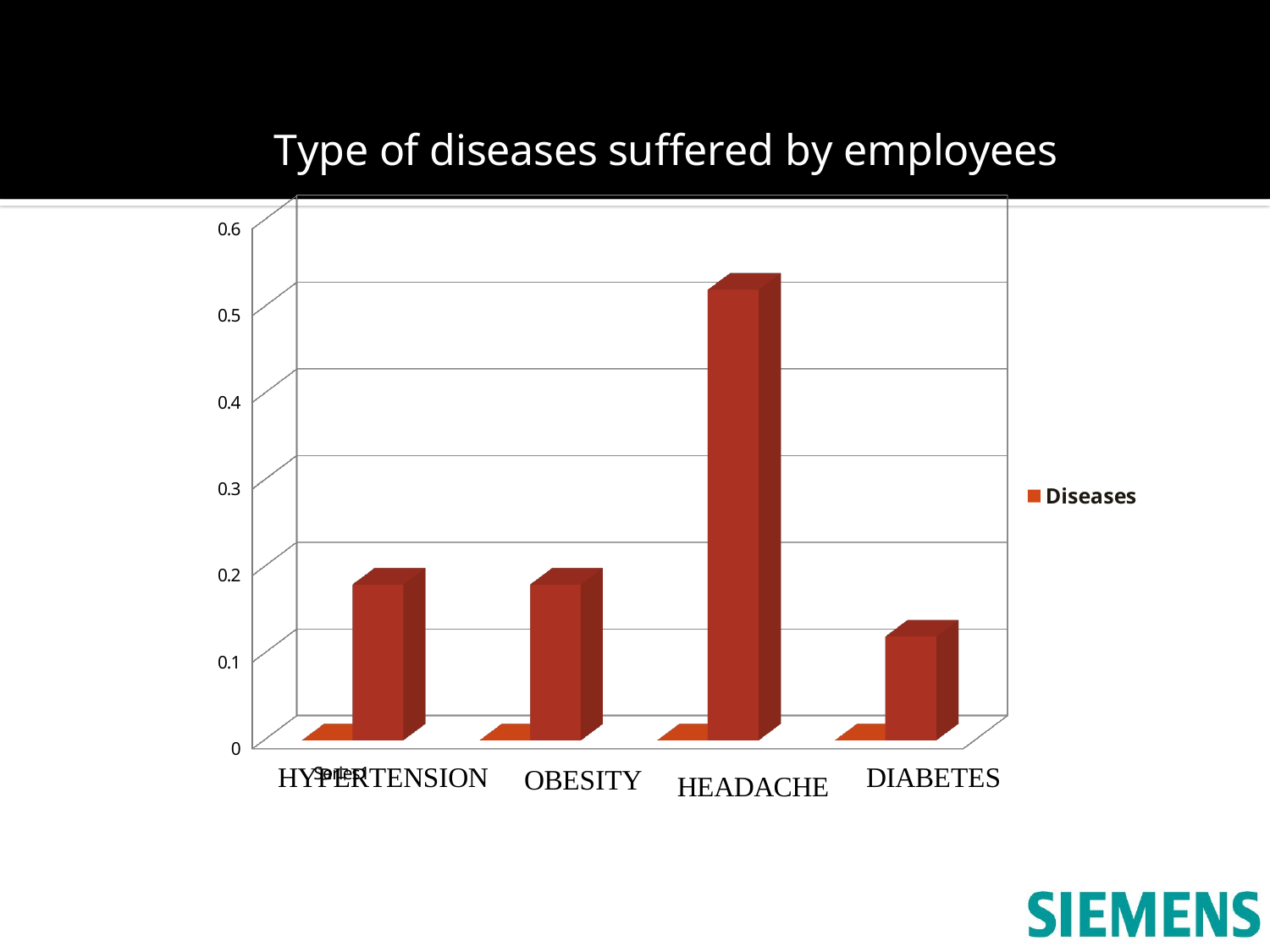
Which has a larger value, OBESITY or DIABETES? OBESITY How many series does the legend list? 1 What is the name of the series shown in the legend? Diseases What kind of chart is shown on the slide? bar chart Is the value for HYPERTENSION greater or less than 0.3? less How many disease categories are shown on the x axis? 4 Which has a larger value, HEADACHE or DIABETES? HEADACHE What is the title of the chart? Type of diseases suffered by employees Is the value for DIABETES greater or less than 0.2? less Is the value for HEADACHE greater or less than 0.4? greater Which disease has the highest value? HEADACHE Which disease has the lowest value? DIABETES